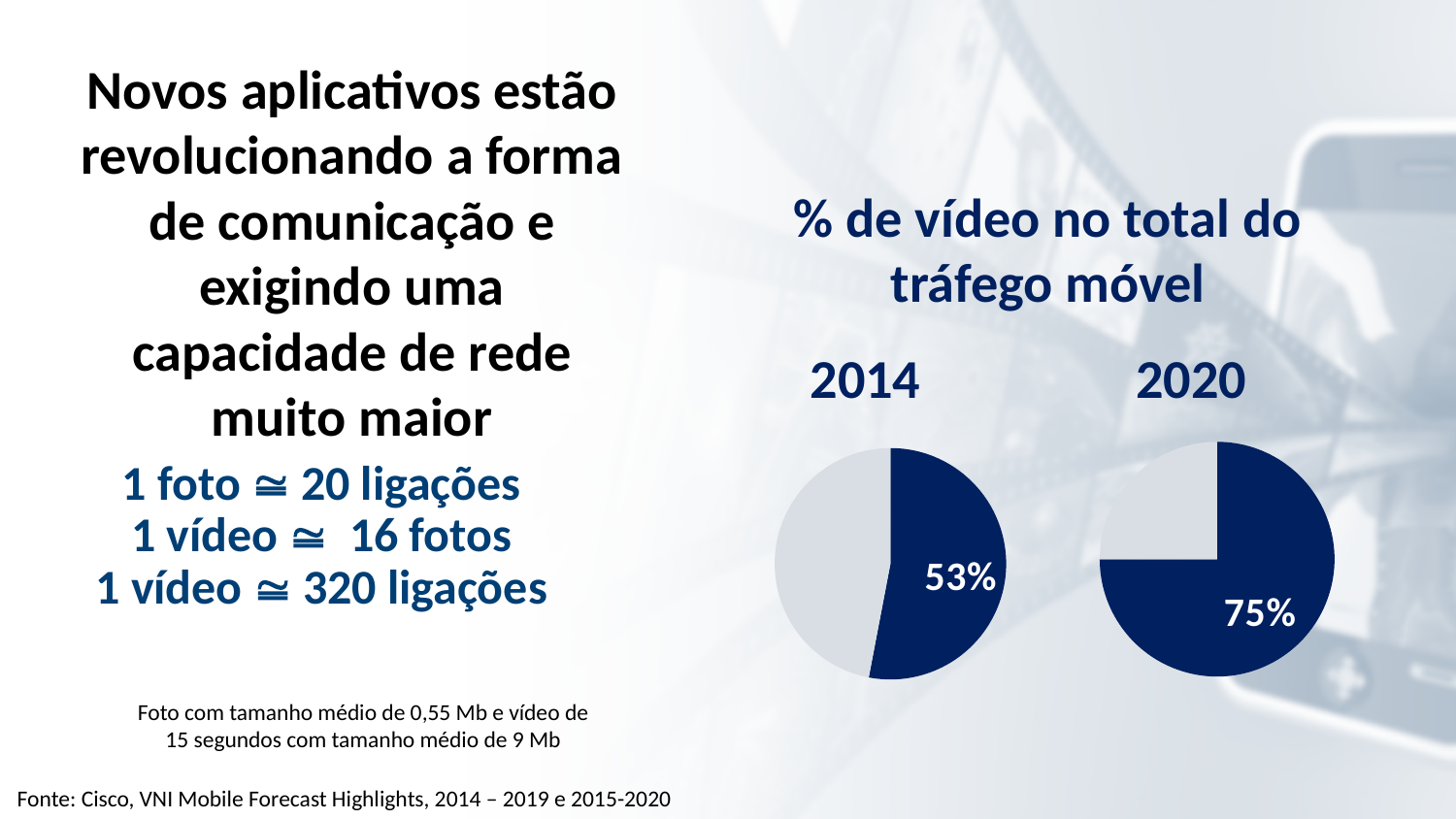
How many pie charts are shown on the slide? 2 How many slices does the 2020 pie chart have? 2 Which year's pie chart shows the larger share of video in mobile traffic, 2014 or 2020? 2020 What type of chart is used to show the share of video in mobile traffic for 2014 and 2020? Pie chart Does the share of video in mobile traffic rise or fall from 2014 to 2020? Rise What is the title of the pie charts on the slide? % de vídeo no total do tráfego móvel In the 2020 pie chart, what percentage of mobile traffic is video? 75% By how many percentage points does the video share in the 2020 pie chart exceed the video share in the 2014 pie chart? 22 percentage points Which two years are compared by the pie charts? 2014 and 2020 In the 2014 pie chart, what percentage of mobile traffic is video? 53% In the 2014 pie chart, is the video share greater or less than 50%? greater